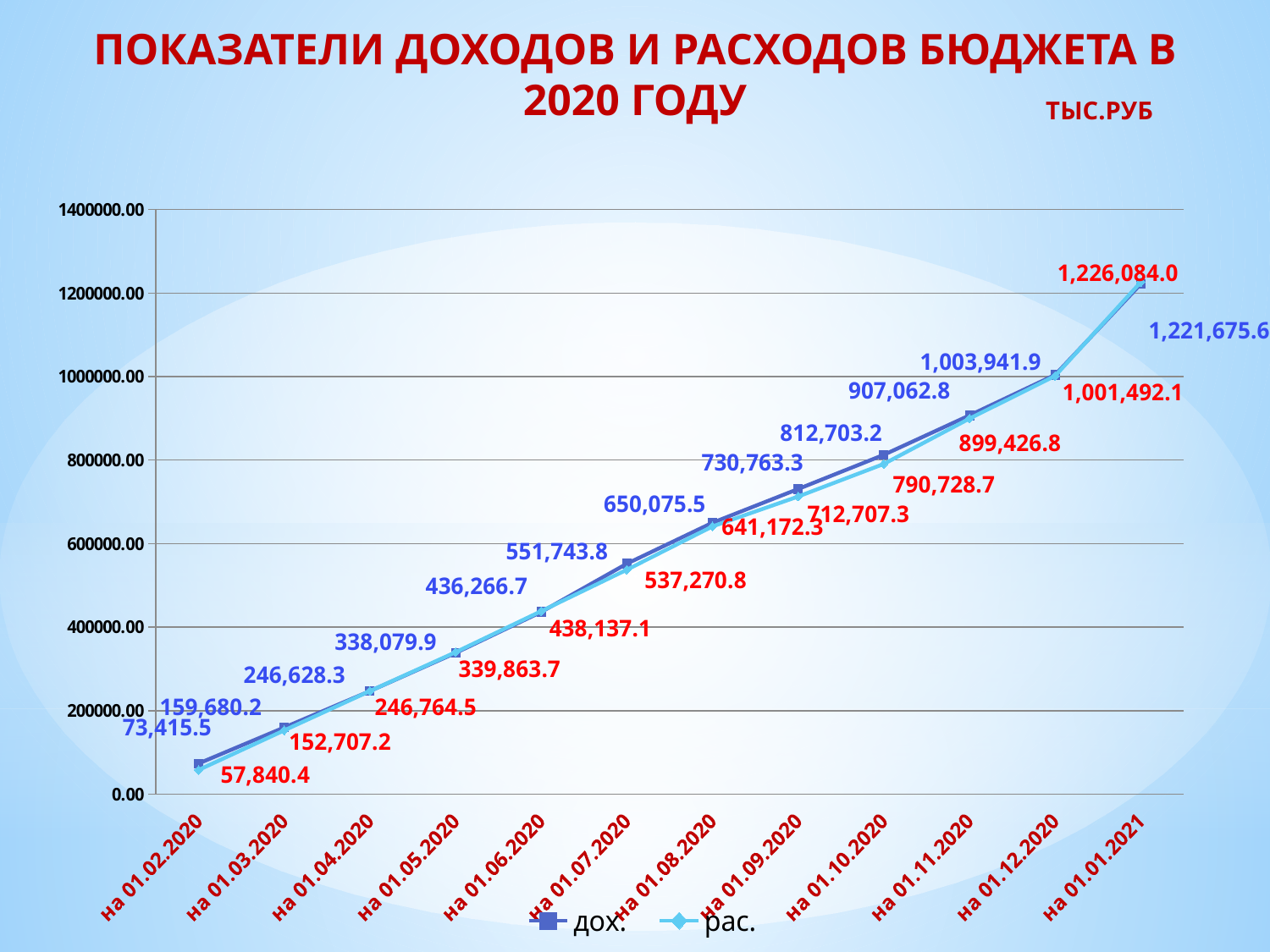
What is the value of рас. на 01.06.2020? 438,137.1 How many dates are plotted along the x axis? 12 Do the values of дох. rise or fall from на 01.02.2020 to на 01.01.2021? rise What is the value of дох. на 01.12.2020? 1,003,941.9 What is the value of дох. на 01.02.2020? 73,415.5 What is the value of рас. на 01.01.2021? 1,226,084.0 How many series does the legend list? 2 What is the difference between дох. and рас. на 01.02.2020? 15,575.1 What type of chart is shown on the slide? line chart At which date is the value of рас. the highest? на 01.01.2021 At which date is the value of дох. the lowest? на 01.02.2020 На 01.10.2020, which is larger, дох. or рас.? дох.